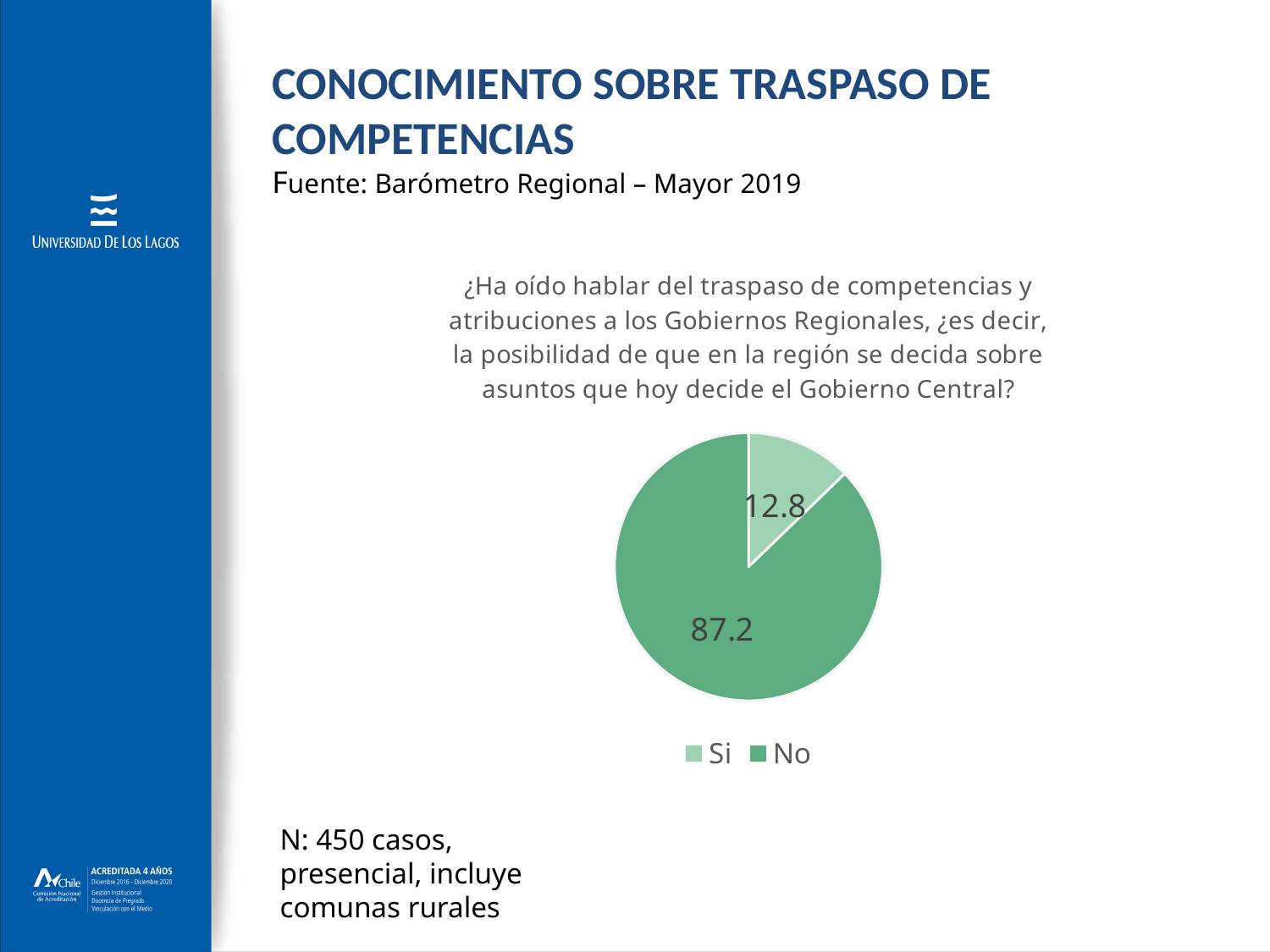
What is the value for "Si" in the pie chart? 12.8 What is the total of the two values shown in the pie chart? 100 How many entries does the legend list? 2 Which is larger, the value for "Si" or the value for "No"? No Which category has the smallest slice in the pie chart? Si Which legend entry is shown in the lighter green colour? Si How many categories does the pie chart show? 2 Which category has the largest slice in the pie chart? No What kind of chart is shown on the slide? pie chart What source is cited for the chart on the slide? Barómetro Regional – Mayor 2019 What is the difference between the values for "No" and "Si"? 74.4 What is the value for "No" in the pie chart? 87.2